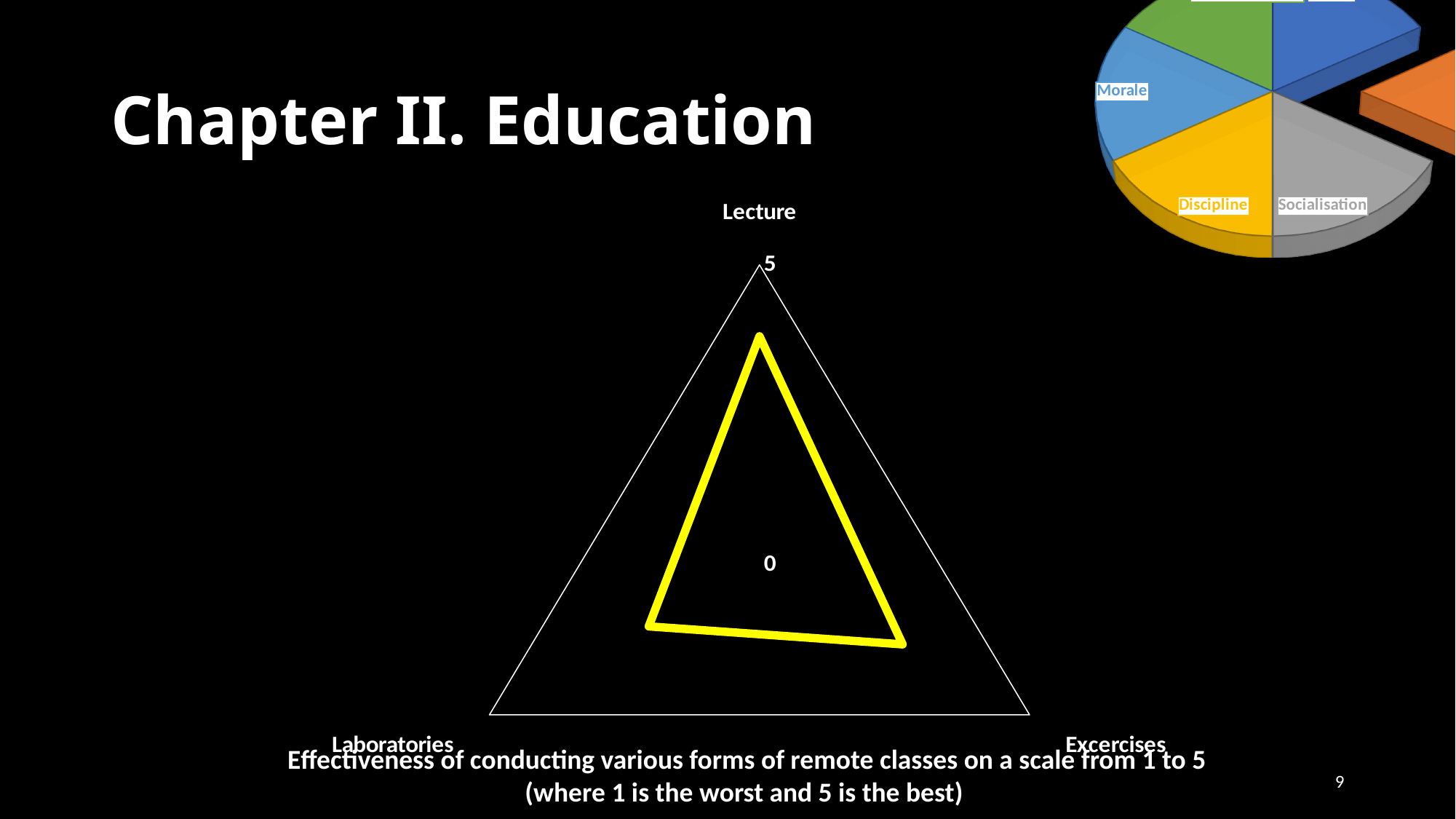
On the radar chart, which is larger: the value for Lecture or the value for Excercises? Lecture Which category has the lowest value on the radar chart? Laboratories Which category has the highest value on the radar chart? Lecture Is the value for Lecture on the radar chart greater or less than 5? less On the radar chart, which is larger: the value for Lecture or the value for Laboratories? Lecture What is the title of the radar chart? Effectiveness of conducting various forms of remote classes on a scale from 1 to 5 (where 1 is the worst and 5 is the best) What is the maximum value shown on the radar chart's axis? 5 What kind of chart is partially visible in the top right corner of the slide? Pie chart What kind of chart is the large chart in the centre of the slide? Radar chart How many categories (axes) does the radar chart have? 3